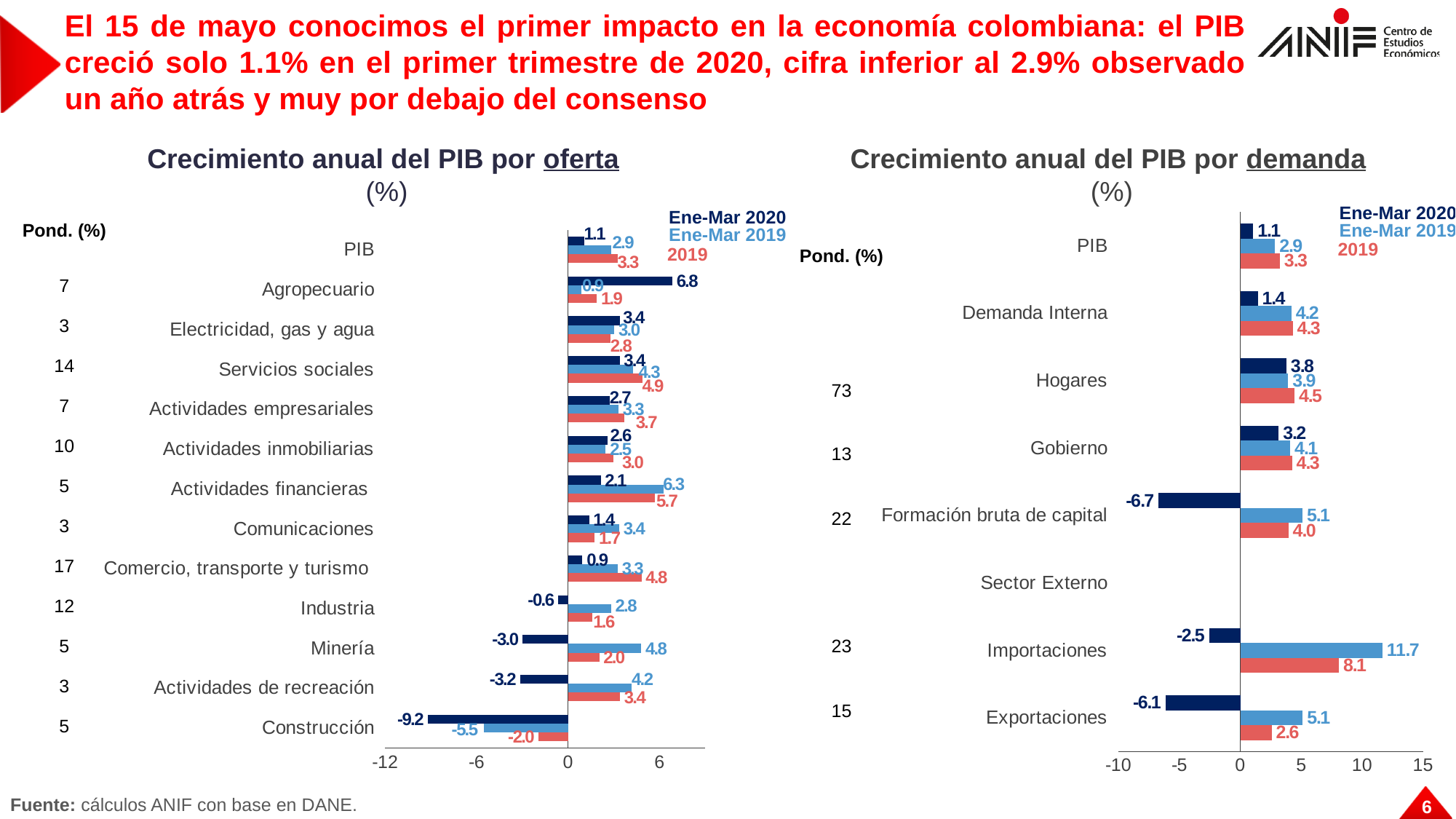
In the 'Crecimiento anual del PIB por oferta' chart, what is the Ene-Mar 2020 value for Construcción? -9.2 In the 'Crecimiento anual del PIB por oferta' chart, which category has the lowest Ene-Mar 2020 value? Construcción In the 'Crecimiento anual del PIB por oferta' chart, what is the Ene-Mar 2020 value for Agropecuario? 6.8 In the 'Crecimiento anual del PIB por demanda' chart, what is the difference between the Ene-Mar 2019 and Ene-Mar 2020 values for Exportaciones? 11.2 In the 'Crecimiento anual del PIB por demanda' chart, which category has the lowest Ene-Mar 2020 value? Formación bruta de capital In the 'Crecimiento anual del PIB por demanda' chart, what is the Ene-Mar 2019 value for Importaciones? 11.7 In the 'Crecimiento anual del PIB por oferta' chart, which category has the highest Ene-Mar 2020 value? Agropecuario What kind of chart is the 'Crecimiento anual del PIB por oferta' chart? Bar chart In the 'Crecimiento anual del PIB por demanda' chart, what is the Ene-Mar 2020 value for Formación bruta de capital? -6.7 In the 'Crecimiento anual del PIB por demanda' chart, which is larger for Hogares: the Ene-Mar 2020 value or the 2019 value? 2019 How many series does the legend list in the 'Crecimiento anual del PIB por demanda' chart? 3 In the 'Crecimiento anual del PIB por oferta' chart, what is the difference between the Ene-Mar 2019 and Ene-Mar 2020 values for Minería? 7.8